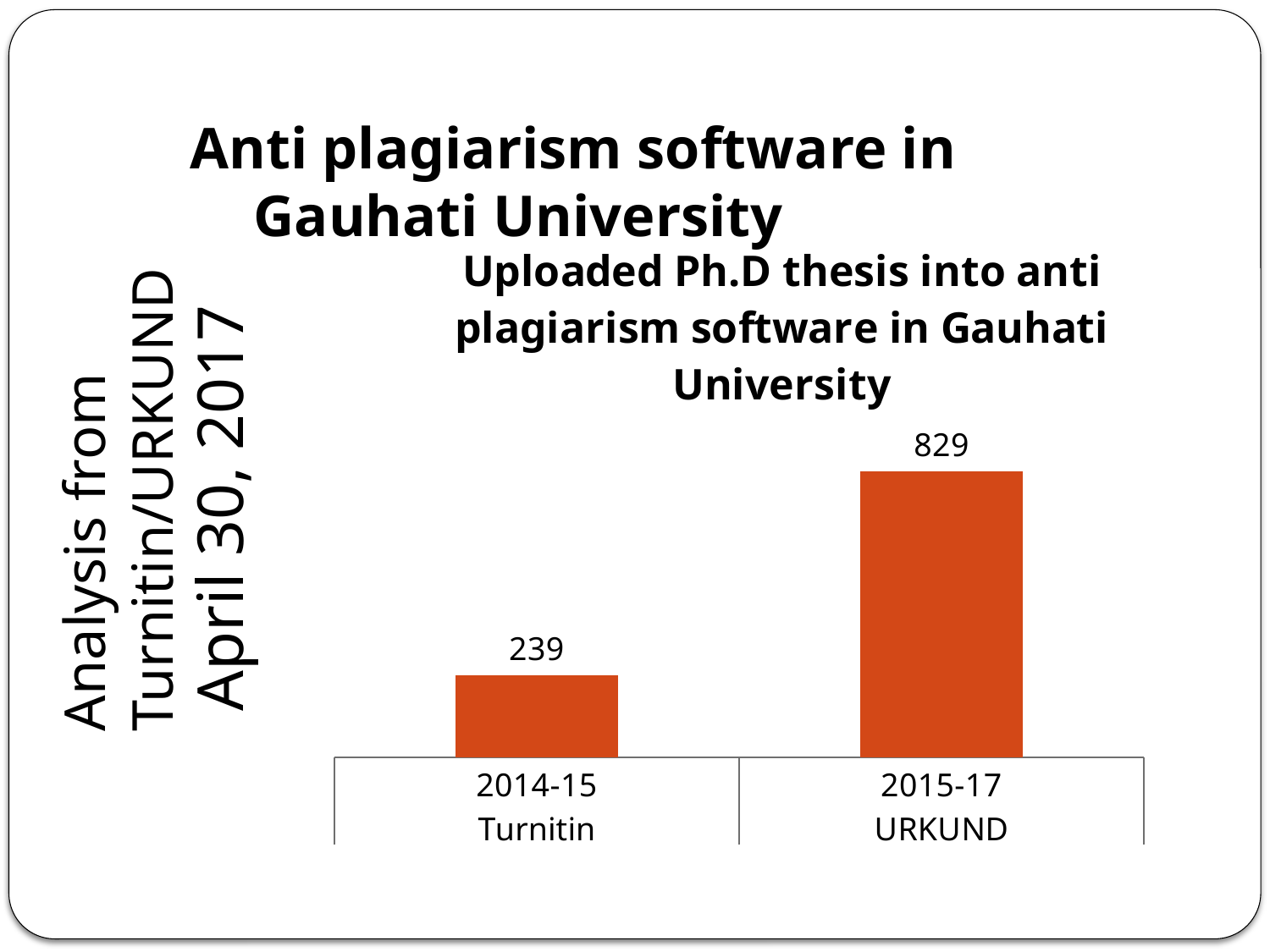
Is the value for 2015-17 URKUND larger or smaller than the value for 2014-15 Turnitin? larger Which category has the higher number of uploaded theses? 2015-17 URKUND What is the difference between the URKUND (2015-17) and Turnitin (2014-15) upload counts? 590 How many categories are shown on the x axis of the chart? 2 How many Ph.D theses were uploaded in 2014-15 (Turnitin)? 239 Which category has the lower number of uploaded theses? 2014-15 Turnitin Do the values rise or fall from 2014-15 to 2015-17? rise What is the total number of uploaded theses across both categories? 1068 What colour are the bars in the chart? orange-red How many Ph.D theses were uploaded in 2015-17 (URKUND)? 829 What is the title of the chart? Uploaded Ph.D thesis into anti plagiarism software in Gauhati University What type of chart is shown on the slide? bar chart